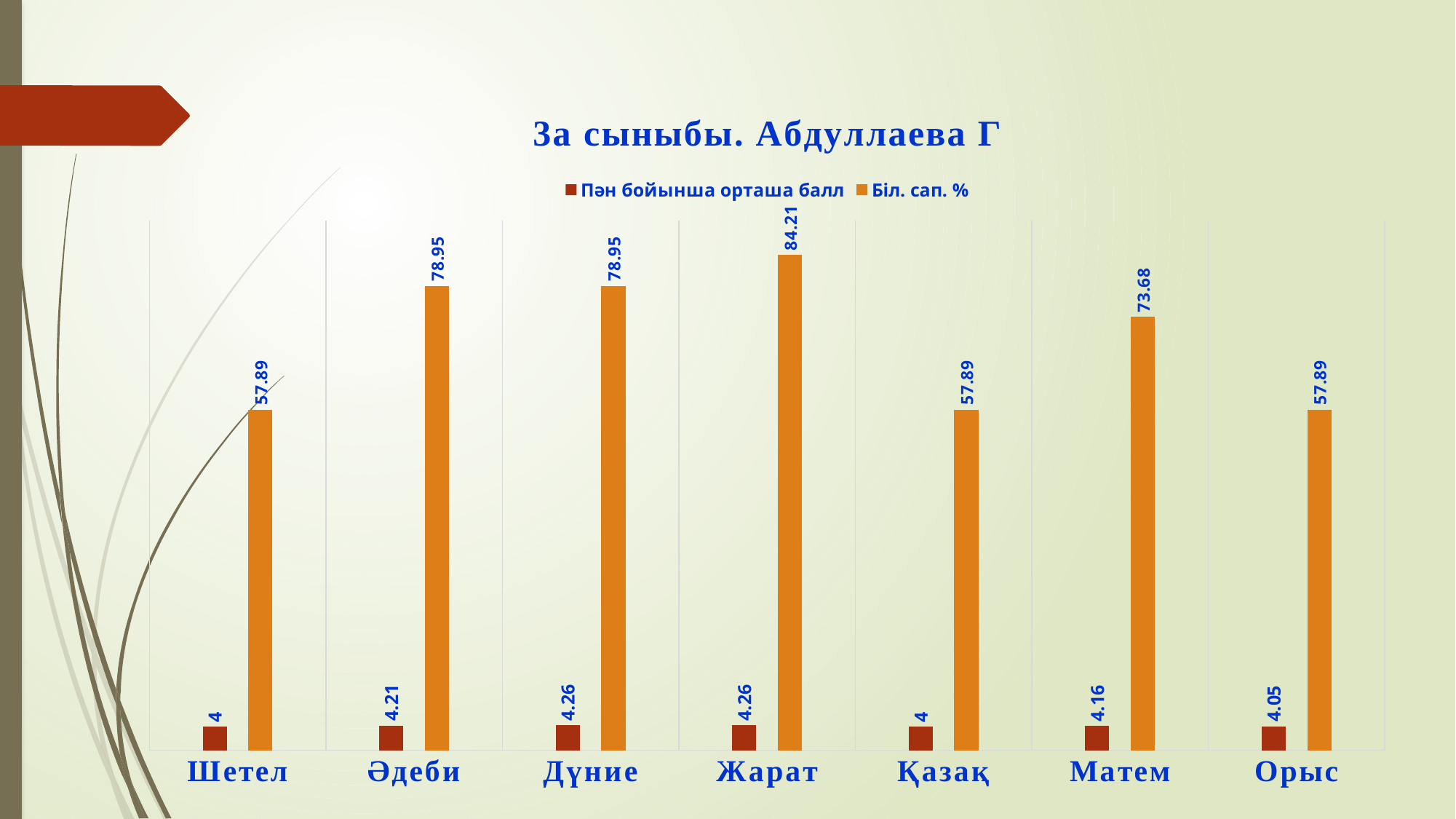
Which category has the highest Біл. сап. % value? Жарат What is the value of Пән бойынша орташа балл for Матем? 4.16 What is the difference between the Біл. сап. % values for Жарат and Матем? 10.53 Which category has the lowest Пән бойынша орташа балл value? Шетел and Қазақ (both 4) What kind of chart is shown on the slide? bar chart What is the difference between the Пән бойынша орташа балл values for Дүние and Шетел? 0.26 How many subject categories are shown on the x axis? 7 What is the value of Біл. сап. % for Жарат? 84.21 Which has a larger Біл. сап. % value, Әдеби or Шетел? Әдеби How many series does the legend list? 2 What is the value of Біл. сап. % for Матем? 73.68 What is the title of the chart? 3а сыныбы. Абдуллаева Г